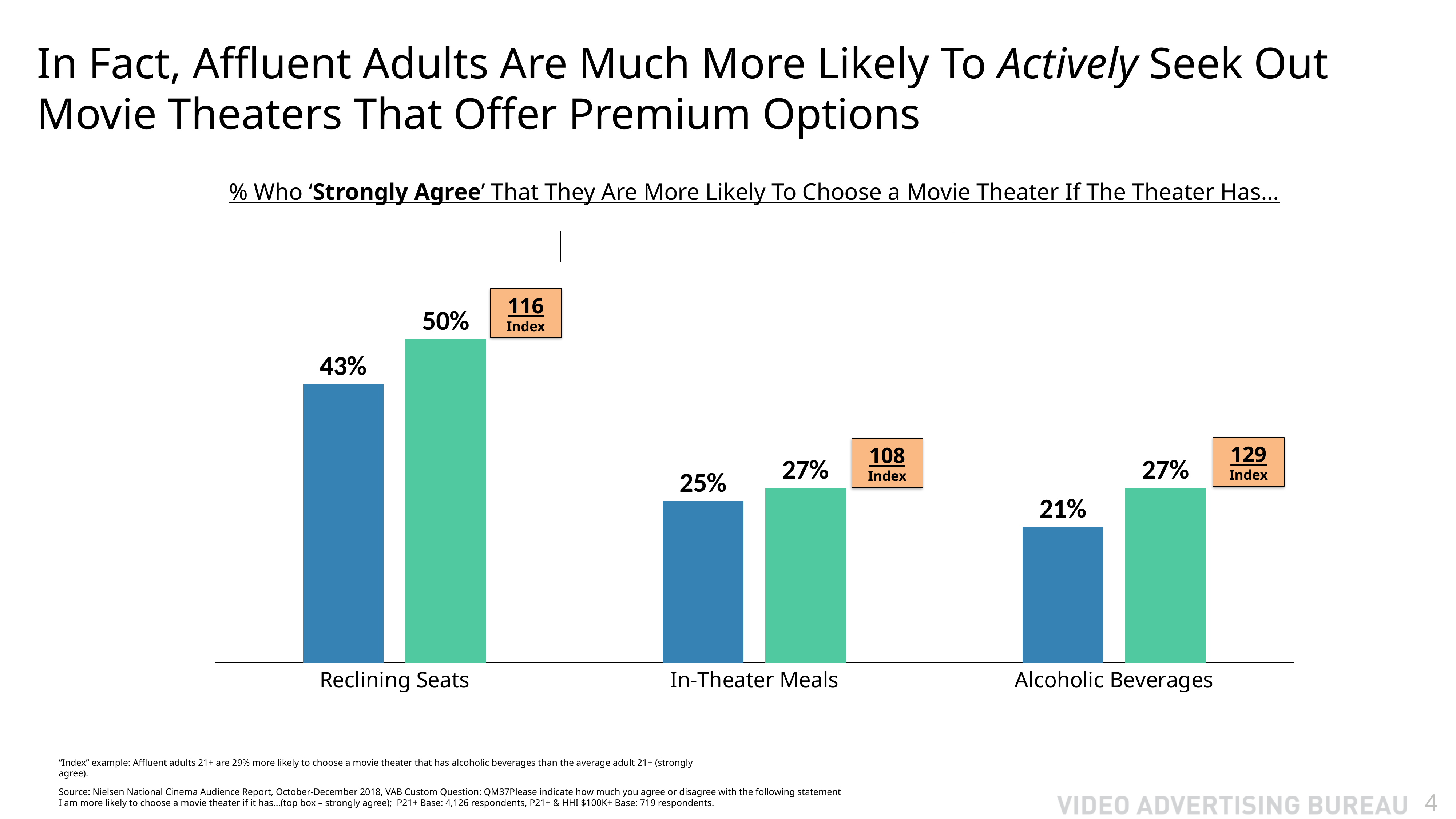
Which category has the highest green bar? Reclining Seats What is the value of the blue bar for Alcoholic Beverages? 21% What index value is shown next to the In-Theater Meals bars? 108 Which is larger for In-Theater Meals, the blue bar or the green bar? the green bar What index value is shown next to the Alcoholic Beverages bars? 129 What is the value of the blue bar for Reclining Seats? 43% How many categories are shown on the x axis of the chart? 3 Which category has the lowest blue bar? Alcoholic Beverages What is the difference between the green bar and the blue bar for Alcoholic Beverages? 6% What is the value of the blue bar for In-Theater Meals? 25% What is the value of the green bar for Reclining Seats? 50% What kind of chart is shown on the slide? bar chart